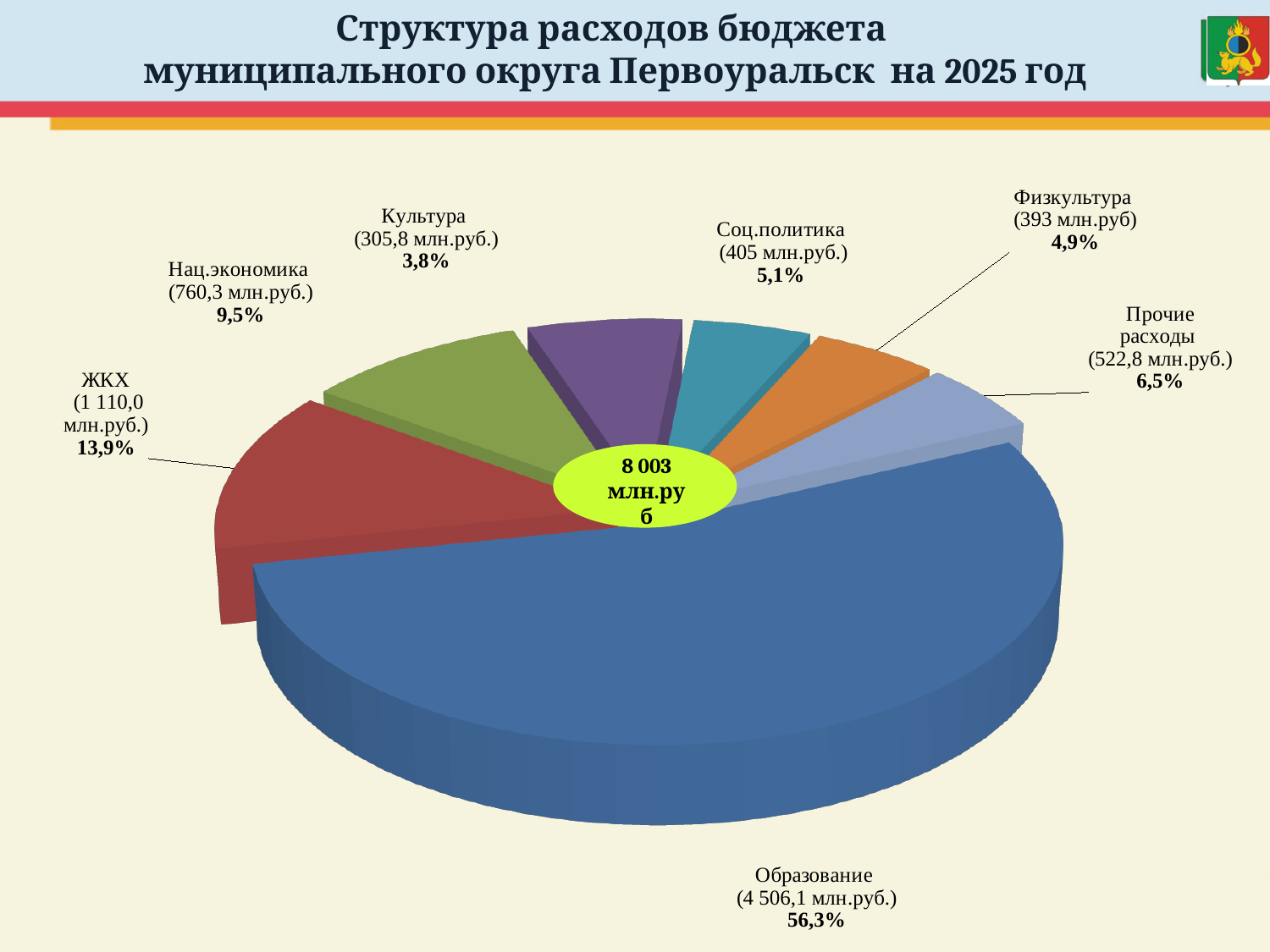
Which category has the largest share of expenditure? Образование What is the amount shown for Культура? 305,8 млн.руб. What is the amount shown for ЖКХ? 1 110,0 млн.руб. What total amount is shown in the centre of the pie chart? 8 003 млн.руб Which category has the smallest share of expenditure? Культура What share of the budget expenditure goes to Образование? 56,3% What kind of chart is shown on the slide? pie chart What percentage is shown for Нац.экономика? 9,5% What is the title of the slide containing the chart? Структура расходов бюджета муниципального округа Первоуральск на 2025 год What is the difference in percentage points between ЖКХ and Нац.экономика? 4,4 How many slices does the pie chart have? 7 Which has a larger share: Соц.политика or Физкультура? Соц.политика